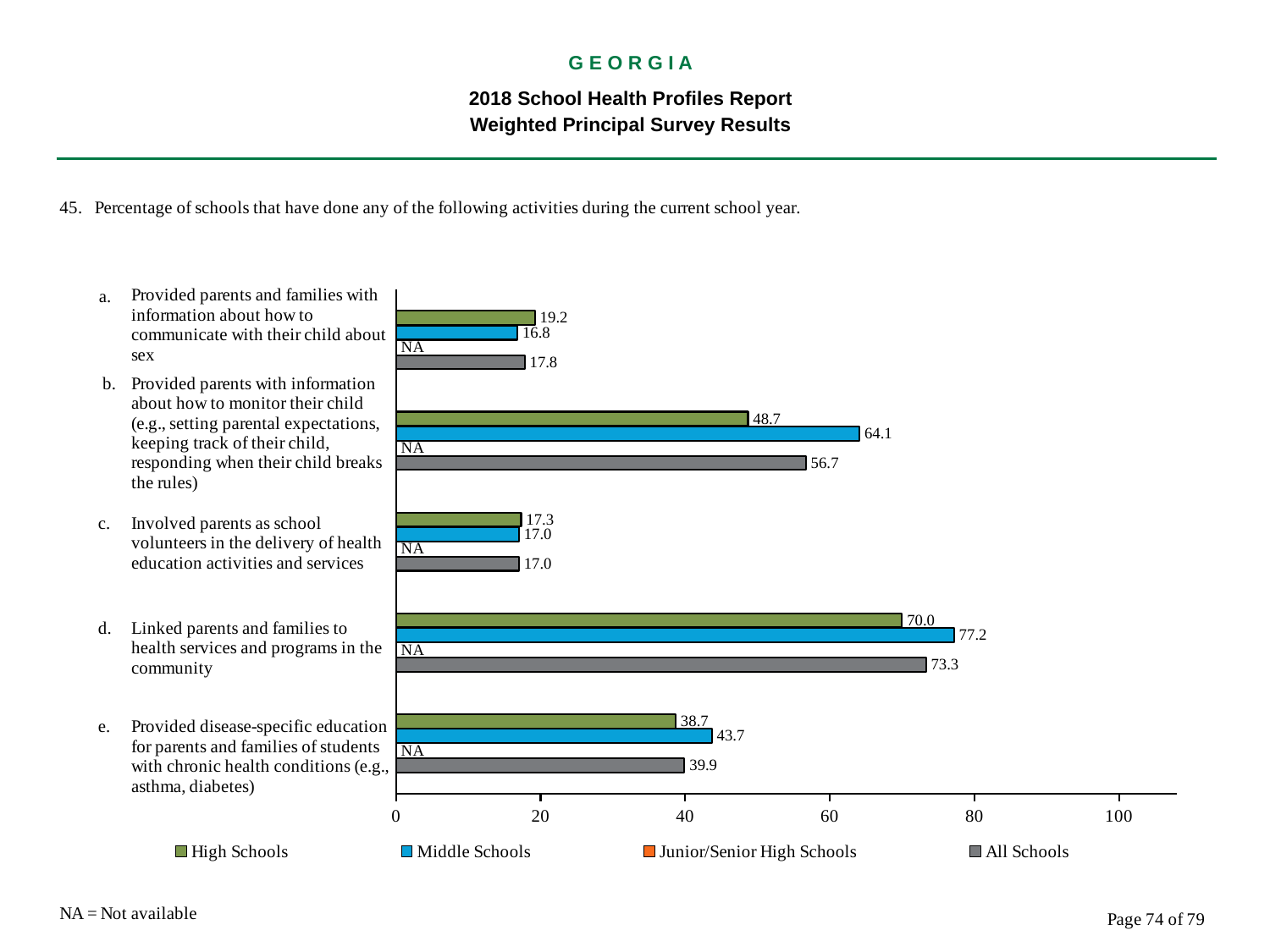
What does NA stand for according to the note on the slide? Not available How many series does the legend list? 4 Which activity has the highest value for High Schools? d. Linked parents and families to health services and programs in the community How many activities (categories) are shown on the chart? 5 Which activity has the lowest value for Middle Schools? a. Provided parents and families with information about how to communicate with their child about sex What is the value for Junior/Senior High Schools for activity e (provided disease-specific education for parents and families)? NA What is the value for Middle Schools for activity d (linked parents and families to health services and programs in the community)? 77.2 For activity e (provided disease-specific education for parents and families), which is larger: the High Schools value or the Middle Schools value? Middle Schools What is the difference between the Middle Schools and High Schools values for activity b (provided parents with information about how to monitor their child)? 15.4 What is the value for All Schools for activity b (provided parents with information about how to monitor their child)? 56.7 What kind of chart is shown on the slide? Bar chart What is the value for High Schools for activity a (provided parents and families with information about how to communicate with their child about sex)? 19.2